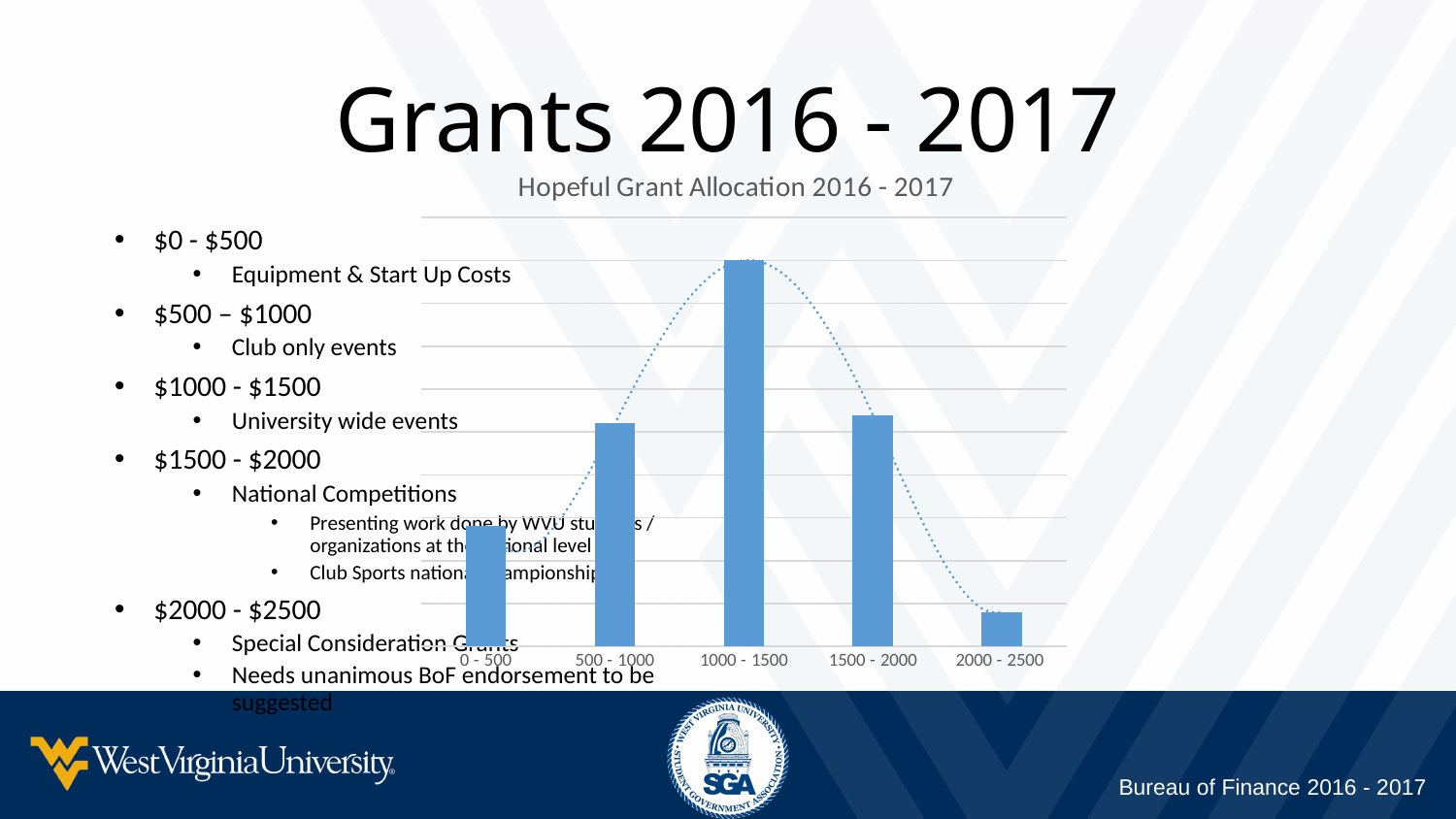
Which bar is taller, 0 - 500 or 2000 - 2500? 0 - 500 Which bar is taller, 1000 - 1500 or 500 - 1000? 1000 - 1500 Which category has the highest bar in the chart? 1000 - 1500 Do the bar values rise or fall from 1000 - 1500 to 2000 - 2500? fall What colour are the bars in the chart? blue How many categories are shown on the x axis of the chart? 5 Which category has the lowest bar in the chart? 2000 - 2500 Which bar is taller, 1500 - 2000 or 2000 - 2500? 1500 - 2000 Do the bar values rise or fall from 0 - 500 to 1000 - 1500? rise What is the title of the chart? Hopeful Grant Allocation 2016 - 2017 What kind of chart is shown on the slide? bar chart